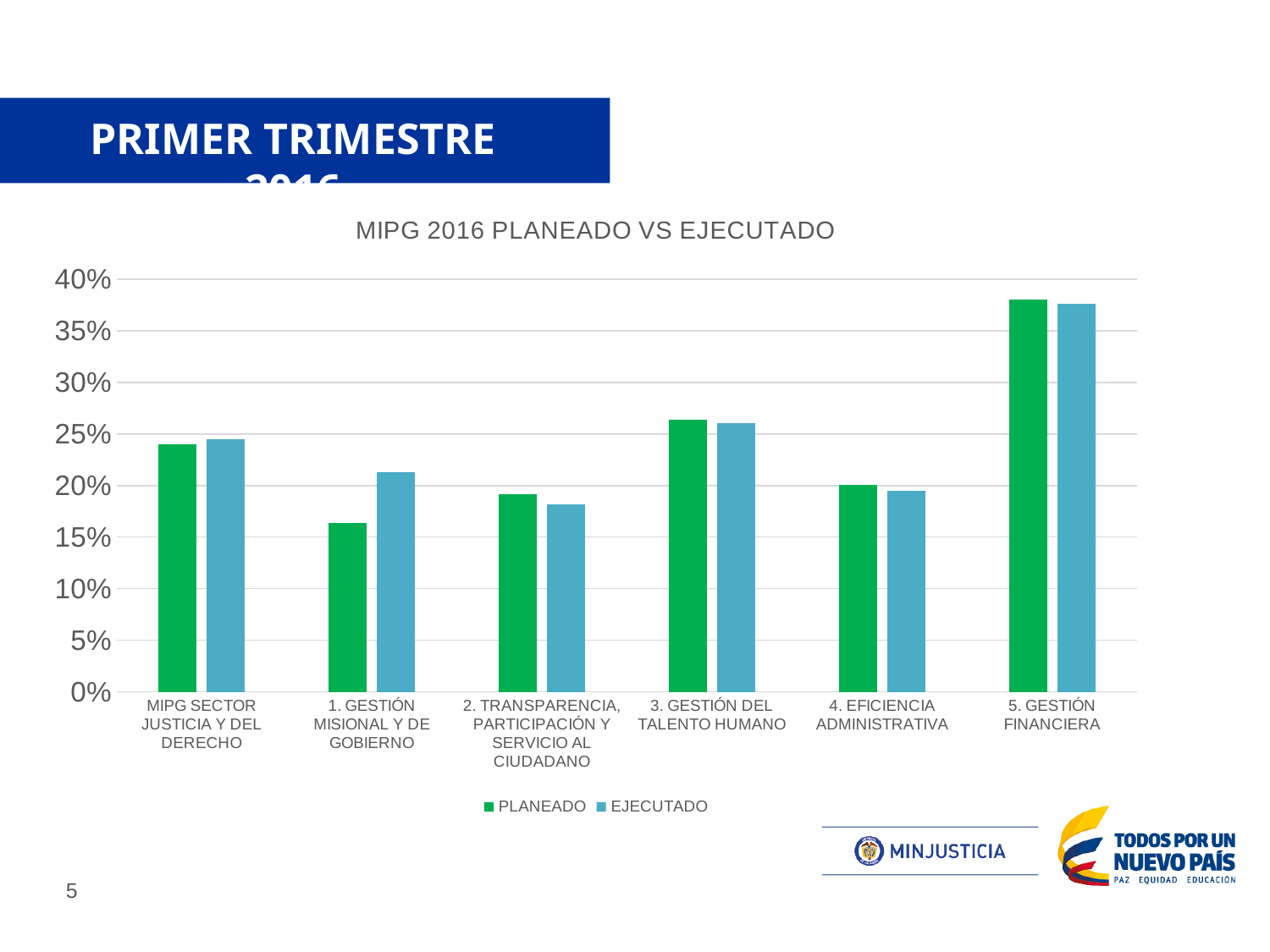
For 1. GESTIÓN MISIONAL Y DE GOBIERNO, which is larger, PLANEADO or EJECUTADO? EJECUTADO Is the PLANEADO value for 3. GESTIÓN DEL TALENTO HUMANO greater or less than 25%? greater Is the PLANEADO value for 1. GESTIÓN MISIONAL Y DE GOBIERNO greater or less than 20%? less What is the title of the chart? MIPG 2016 PLANEADO VS EJECUTADO Which category has the highest PLANEADO value? 5. GESTIÓN FINANCIERA Which category has the lowest PLANEADO value? 1. GESTIÓN MISIONAL Y DE GOBIERNO How many categories are shown on the x axis? 6 Which category has the highest EJECUTADO value? 5. GESTIÓN FINANCIERA Is the PLANEADO value for 5. GESTIÓN FINANCIERA greater or less than 35%? greater How many series does the legend list? 2 Which colour represents the EJECUTADO series in the legend? Blue What type of chart is shown on the slide? Bar chart